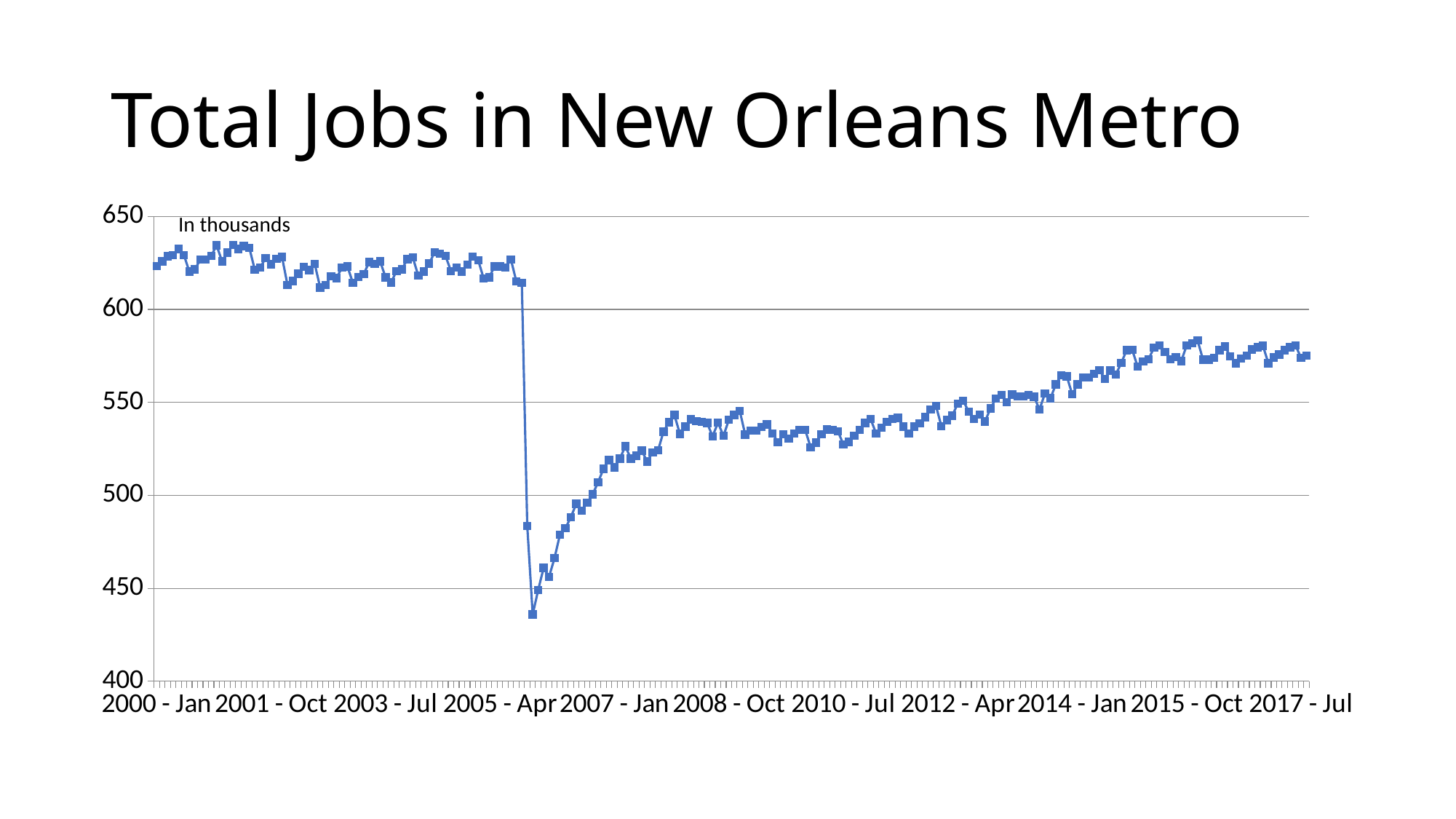
Is the value for 2007 - Jan greater or less than 550? less Is the value for 2000 - Jan greater or less than 600? greater What unit note is printed inside the chart area near the top left? In thousands Is the value for 2017 - Jul greater or less than 550? greater Between which two labelled x-axis dates does the sharp drop in the line occur? 2005 - Apr and 2007 - Jan What kind of chart is shown on the slide? line chart Between 2008 - Oct and 2017 - Jul, do the values generally rise or fall? rise Which is larger, the value for 2000 - Jan or the value for 2017 - Jul? 2000 - Jan What is the title of the chart? Total Jobs in New Orleans Metro